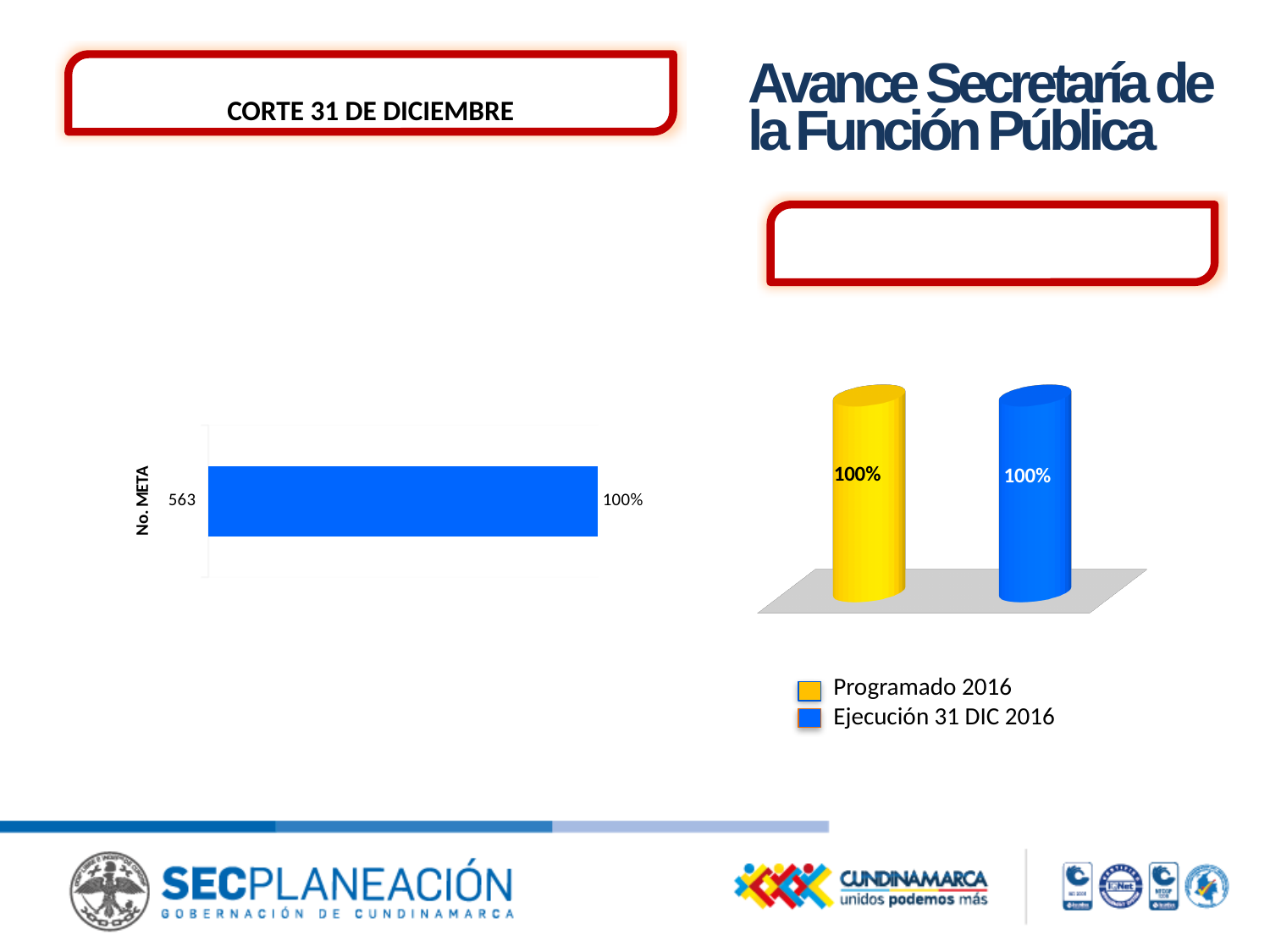
What kind of chart is the chart on the left of the slide? bar chart On the right chart, what is the value for Ejecución 31 DIC 2016? 100% On the right chart, which colour represents Programado 2016? yellow On the left chart, what value is printed next to the bar for category 563? 100% On the right chart, how many series does the legend list? 2 On the left chart, what is the label on the vertical axis? No. META On the right chart, how many bars are plotted? 2 On the right chart, what is the value for Programado 2016? 100% On the left chart, how many bars are plotted? 1 On the right chart, what is the difference between the value for Programado 2016 and the value for Ejecución 31 DIC 2016? 0% What kind of chart is the chart on the right of the slide? bar chart